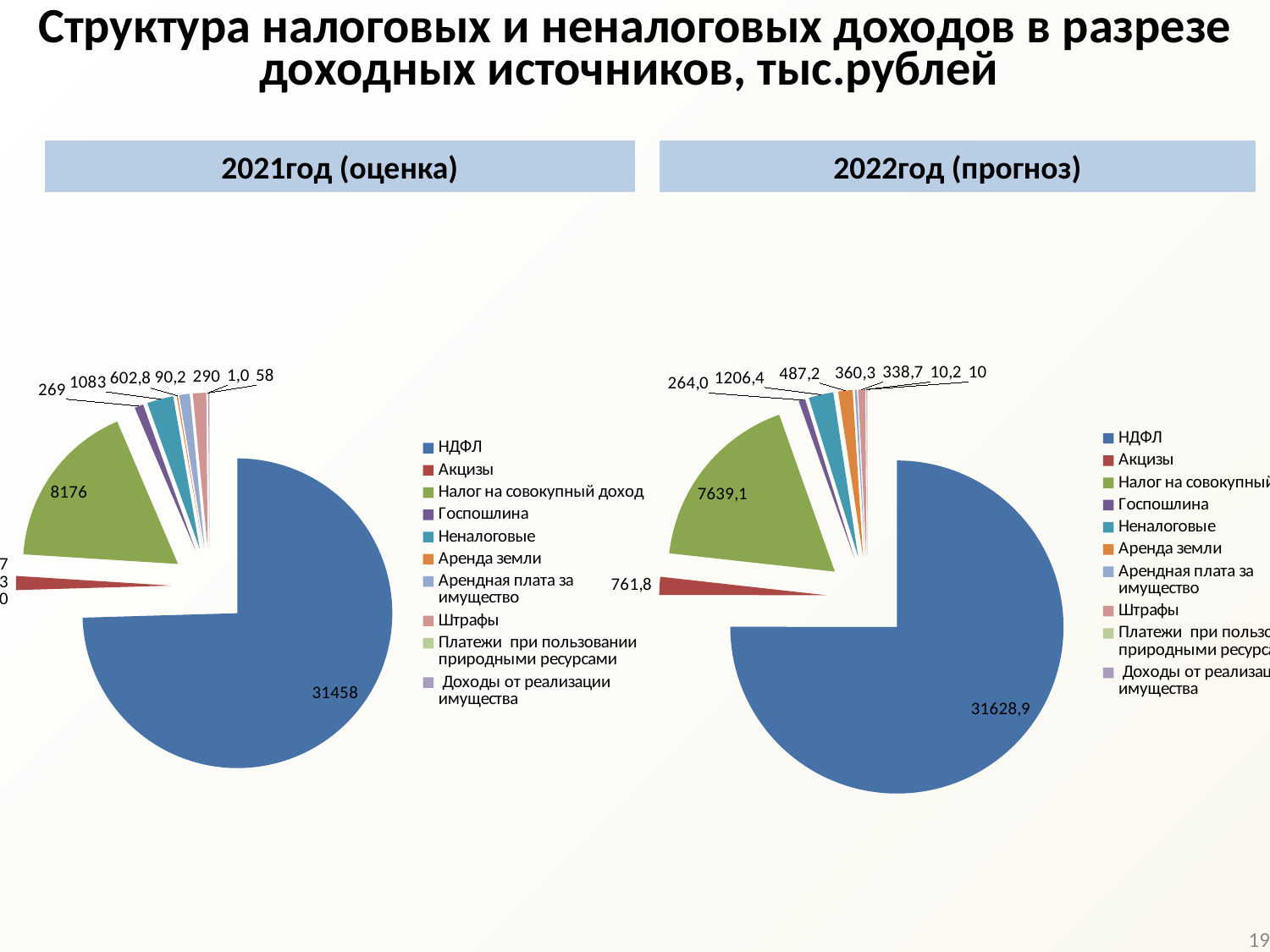
How many categories does the legend of the 2021год (оценка) chart list? 10 In the 2022год (прогноз) chart, what is the value for Акцизы? 761,8 In the 2021год (оценка) chart, which category has the largest slice? НДФЛ In the 2022год (прогноз) chart, what is the difference between the values for НДФЛ and Налог на совокупный доход? 23989,8 What is the difference between the Налог на совокупный доход value in the 2021год (оценка) chart and in the 2022год (прогноз) chart? 536,9 In the 2021год (оценка) chart, what is the value for Налог на совокупный доход? 8176 Is the value for НДФЛ larger in the 2021год (оценка) chart or in the 2022год (прогноз) chart? 2022год (прогноз) In the 2021год (оценка) chart, what is the value for НДФЛ? 31458 In the 2022год (прогноз) chart, what is the value for Налог на совокупный доход? 7639,1 In the 2022год (прогноз) chart, what is the value for НДФЛ? 31628,9 What kind of chart is used on the slide for 2021год (оценка) and 2022год (прогноз)? Pie chart In the 2022год (прогноз) chart, which category has the largest slice? НДФЛ